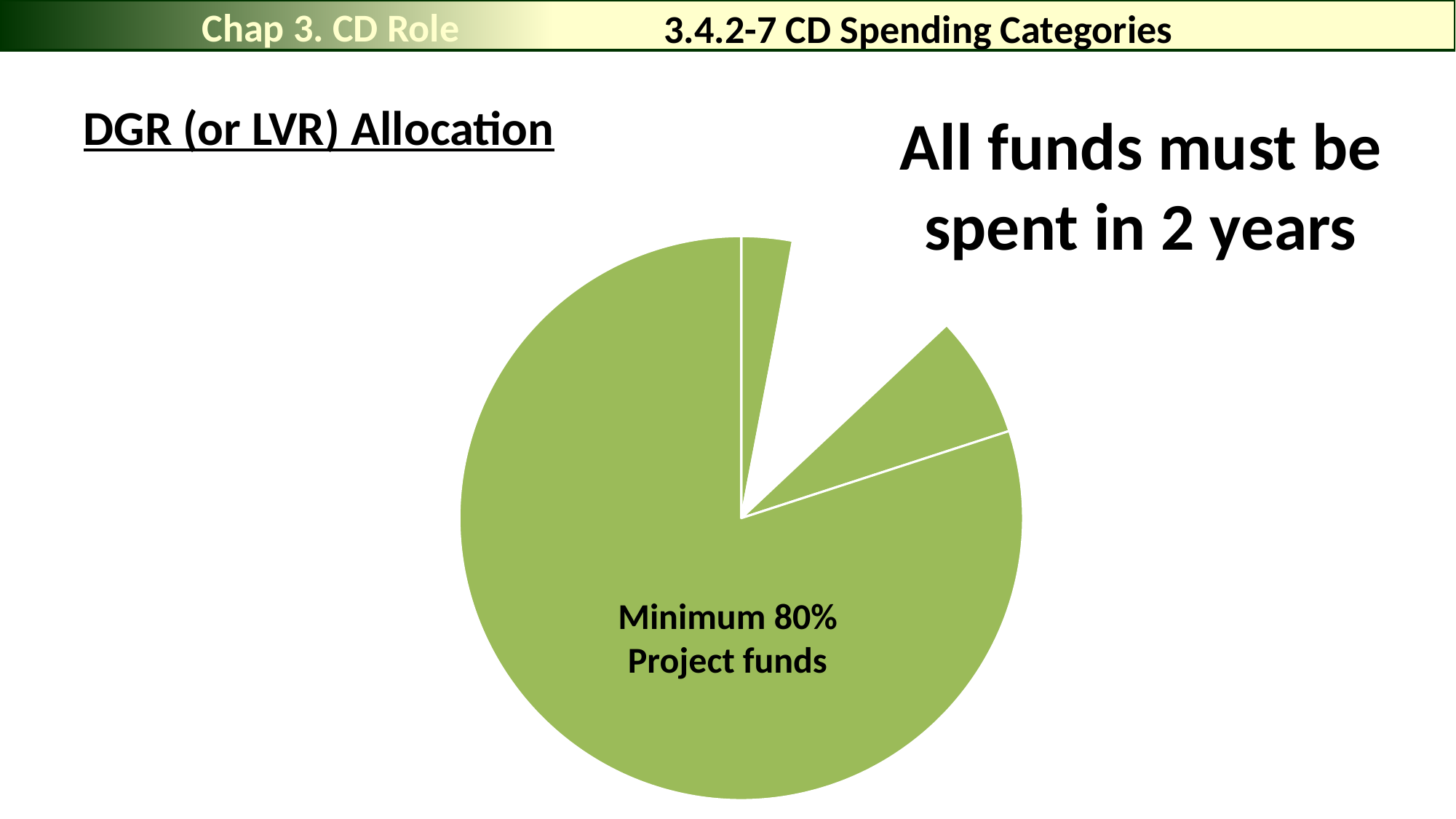
What label is printed on the largest slice of the pie chart? Minimum 80% Project funds What colour are the slices of the pie chart? green What is the title of the chart on the slide? DGR (or LVR) Allocation What share of the pie is labelled for Project funds? Minimum 80% Which slice of the pie chart is the largest? Project funds Is the share for Project funds greater or less than 50%? greater What kind of chart is shown on the slide? pie chart